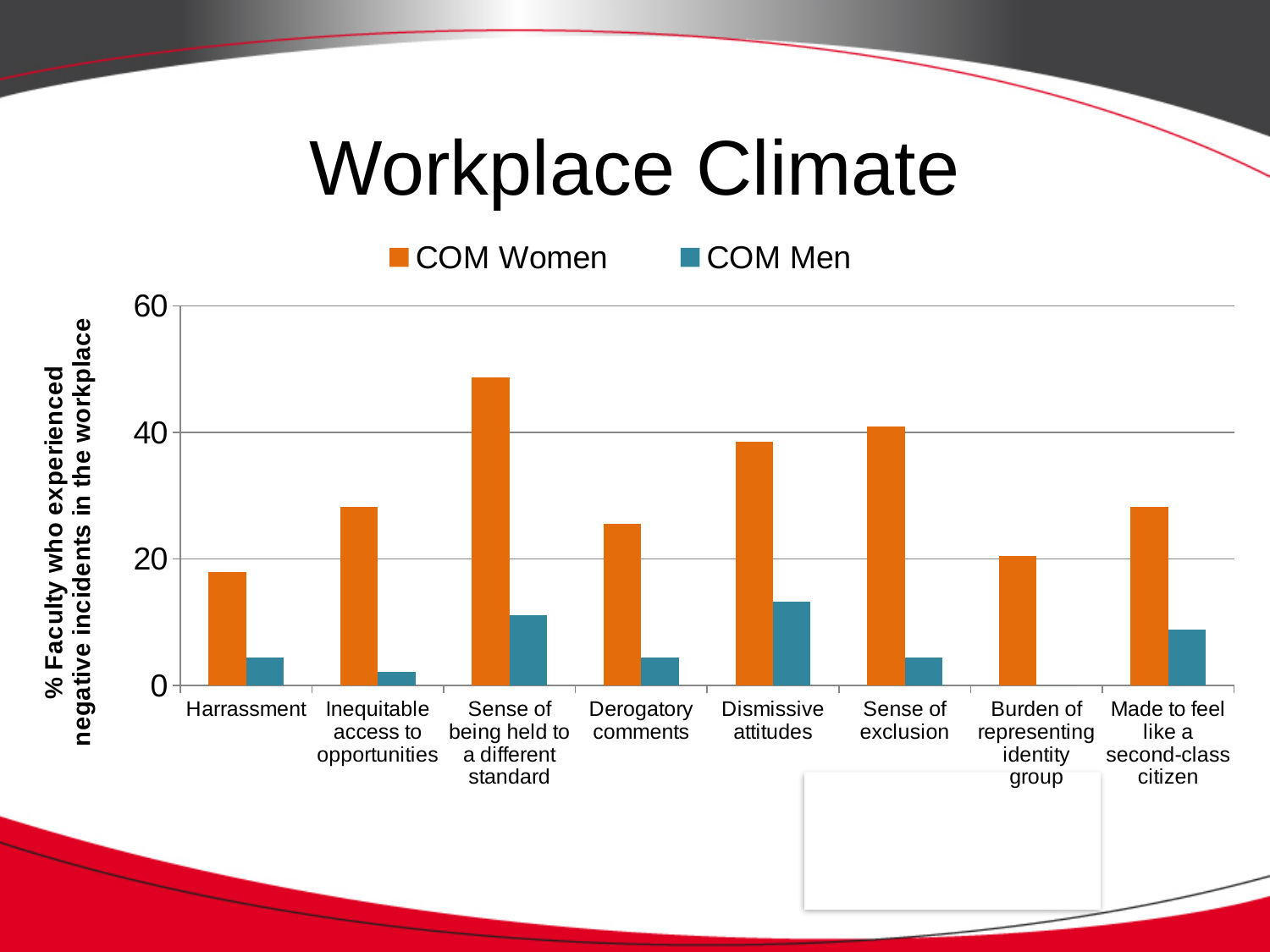
For Harrassment, which series has the larger value, COM Women or COM Men? COM Women For COM Women, which is larger: Sense of being held to a different standard or Sense of exclusion? Sense of being held to a different standard Is the COM Women value for Inequitable access to opportunities greater or less than 20? greater Is the COM Women value for Sense of being held to a different standard greater or less than 40? greater How many categories are shown along the x axis? 8 What is the title of the chart? Workplace Climate What kind of chart is shown on the slide? bar chart How many series does the legend list? 2 Which category has the lowest value for COM Men? Burden of representing identity group Is the COM Men value for Dismissive attitudes greater or less than 20? less Which category has the highest value for COM Women? Sense of being held to a different standard